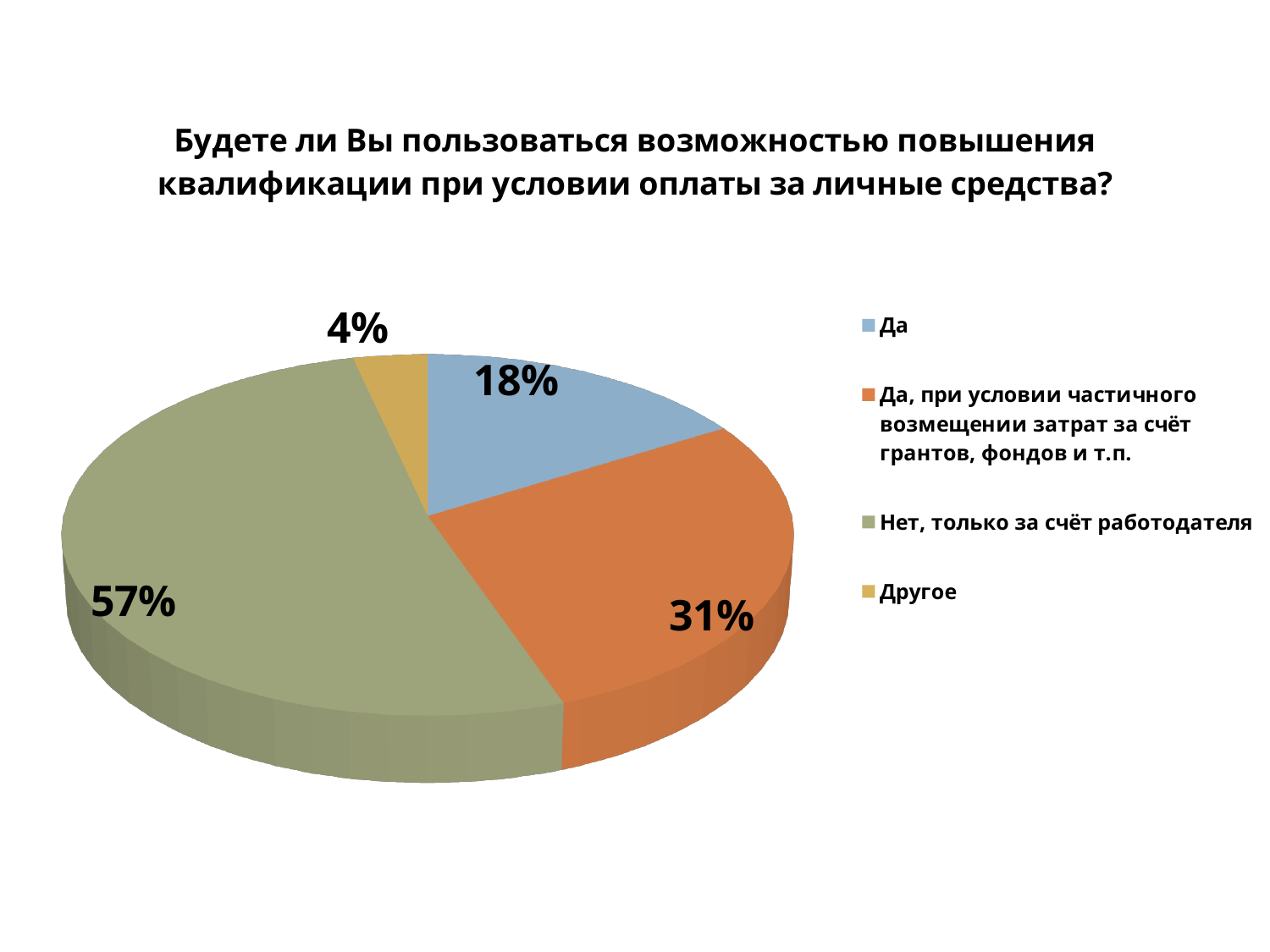
What is the difference between the values for "Нет, только за счёт работодателя" and "Да"? 39% What is the value for "Другое"? 4% What colour is the slice for "Другое"? Yellow Which is larger: the value for "Да" or the value for "Да, при условии частичного возмещении затрат за счёт грантов, фондов и т.п."? Да, при условии частичного возмещении затрат за счёт грантов, фондов и т.п. What kind of chart is shown on the slide? Pie chart What share of the pie does "Да" represent? 18% What share of the pie does "Нет, только за счёт работодателя" represent? 57% What is the difference between the values for "Да, при условии частичного возмещении затрат за счёт грантов, фондов и т.п." and "Другое"? 27% Which category has the smallest slice of the pie? Другое How many categories does the pie chart show? 4 Which category has the largest slice of the pie? Нет, только за счёт работодателя What is the value for "Да, при условии частичного возмещении затрат за счёт грантов, фондов и т.п."? 31%